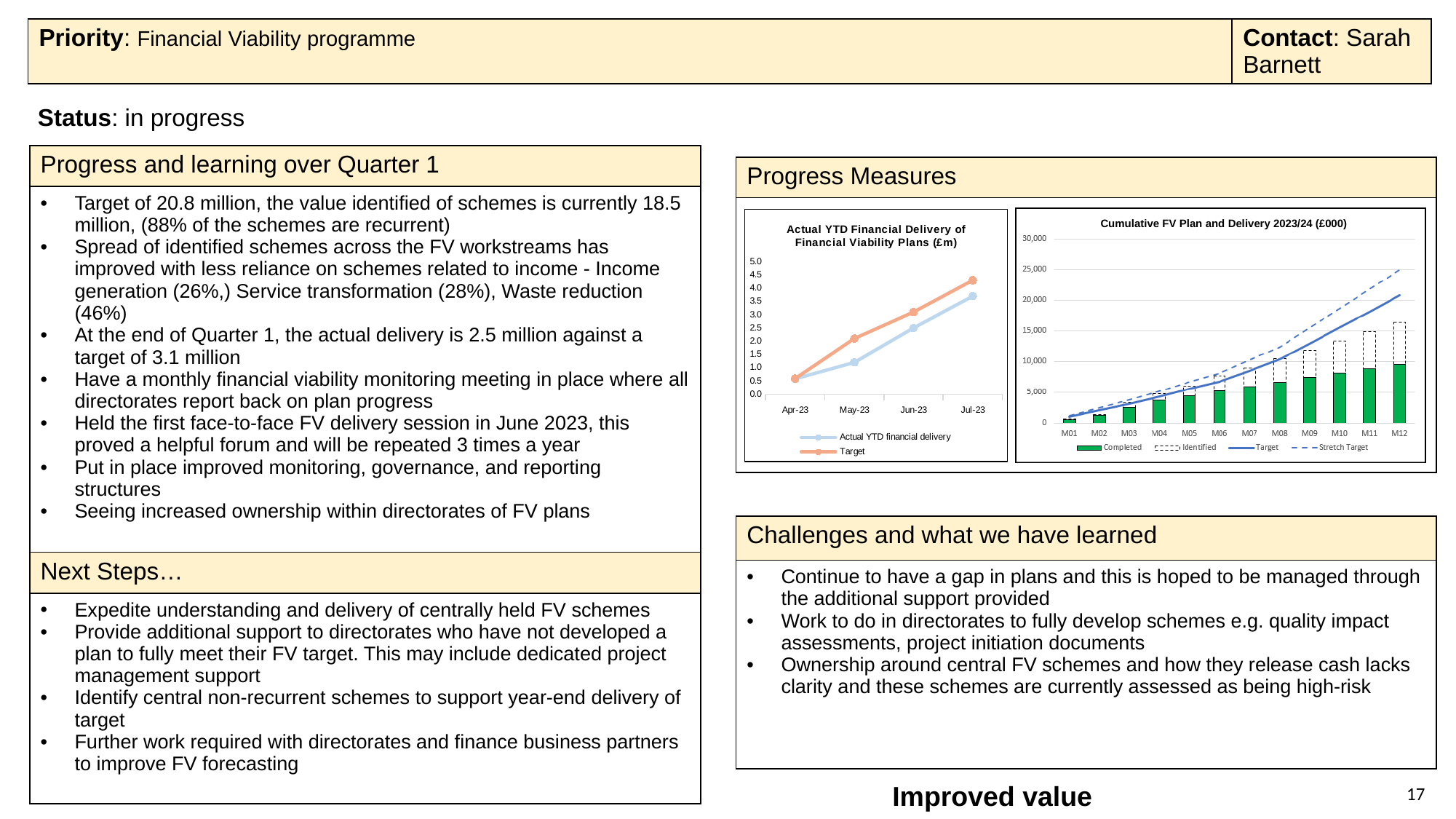
In the 'Actual YTD Financial Delivery of Financial Viability Plans (£m)' chart, is the Actual YTD financial delivery value for Jul-23 greater or less than 4.0? less What kind of chart is the 'Actual YTD Financial Delivery of Financial Viability Plans (£m)' chart? Line chart In the 'Cumulative FV Plan and Delivery 2023/24 (£000)' chart, which line is higher at M12, Stretch Target or Target? Stretch Target How many series does the legend of the 'Cumulative FV Plan and Delivery 2023/24 (£000)' chart list? 4 How many months are shown on the x axis of the 'Cumulative FV Plan and Delivery 2023/24 (£000)' chart? 12 How many months are plotted on the x axis of the 'Actual YTD Financial Delivery of Financial Viability Plans (£m)' chart? 4 How many series does the legend of the 'Actual YTD Financial Delivery of Financial Viability Plans (£m)' chart list? 2 In the 'Actual YTD Financial Delivery of Financial Viability Plans (£m)' chart, which series is higher at Jul-23, Target or Actual YTD financial delivery? Target In the 'Actual YTD Financial Delivery of Financial Viability Plans (£m)' chart, does the Actual YTD financial delivery line rise or fall from Apr-23 to Jul-23? Rise In the 'Cumulative FV Plan and Delivery 2023/24 (£000)' chart, is the Target value at M12 greater or less than 20,000? greater In the 'Actual YTD Financial Delivery of Financial Viability Plans (£m)' chart, is the Target value for Jul-23 greater or less than 4.0? greater